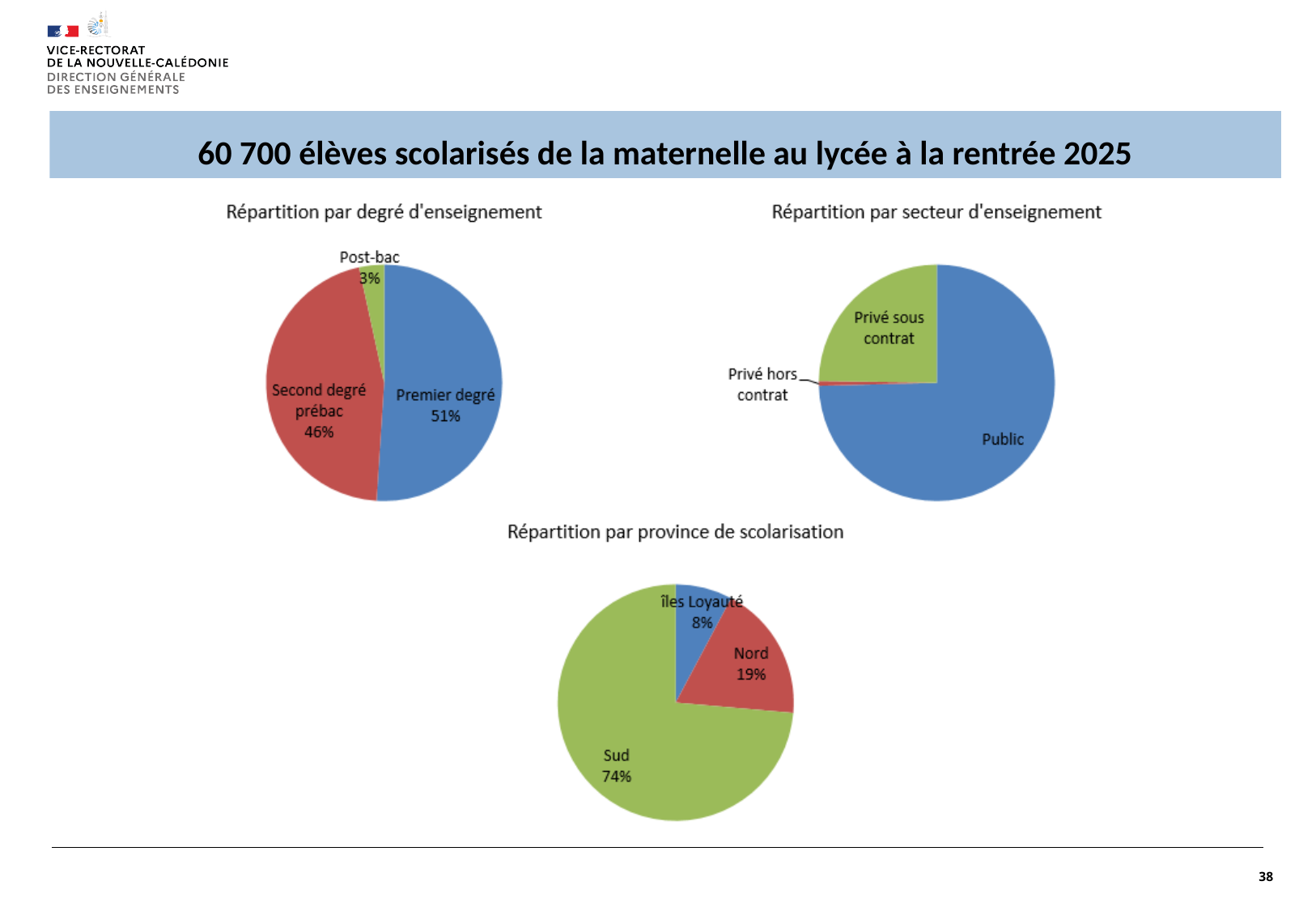
In the chart titled "Répartition par secteur d'enseignement", which sector has the largest slice? Public In the chart titled "Répartition par province de scolarisation", how many provinces are shown? 3 In the chart titled "Répartition par province de scolarisation", which province has the largest slice? Sud In the chart titled "Répartition par degré d'enseignement", what share is shown for Second degré prébac? 46% In the chart titled "Répartition par province de scolarisation", what share is shown for Sud? 74% In the chart titled "Répartition par province de scolarisation", what share is shown for Nord? 19% What kind of chart is the chart titled "Répartition par secteur d'enseignement"? Pie chart In the chart titled "Répartition par degré d'enseignement", what share is shown for Premier degré? 51% In the chart titled "Répartition par degré d'enseignement", what is the difference between the Premier degré and Second degré prébac shares? 5% In the chart titled "Répartition par degré d'enseignement", what share is shown for Post-bac? 3% In the chart titled "Répartition par degré d'enseignement", which category has the smallest slice? Post-bac In the chart titled "Répartition par province de scolarisation", what share is shown for îles Loyauté? 8%